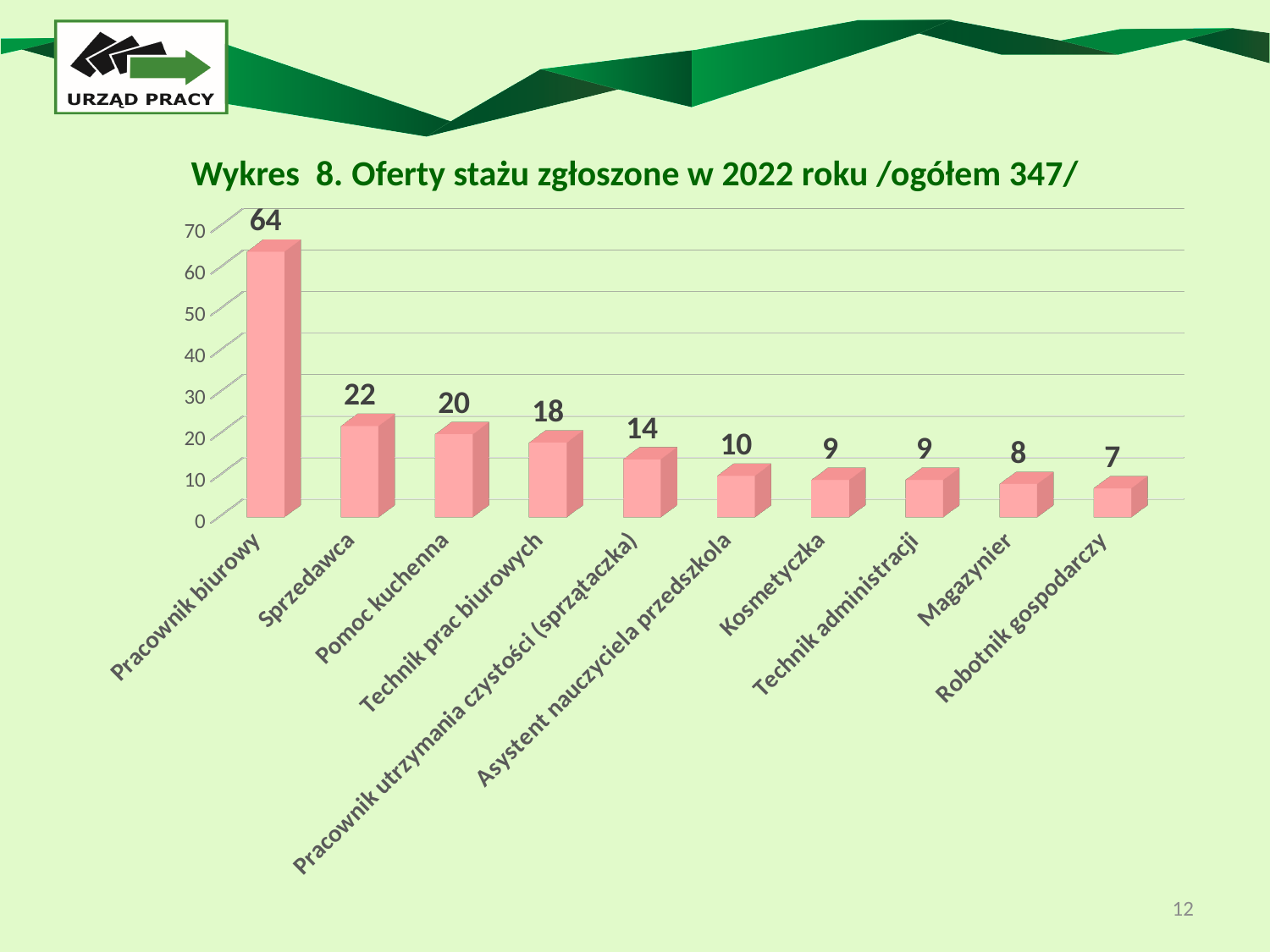
Which is larger, the value for Pracownik utrzymania czystości (sprzątaczka) or the value for Magazynier? Pracownik utrzymania czystości (sprzątaczka) What is the difference between the values for Pomoc kuchenna and Technik prac biurowych? 2 How many categories are shown on the chart? 10 What is the difference between the values for Pracownik biurowy and Sprzedawca? 42 What is the title of the chart? Wykres 8. Oferty stażu zgłoszone w 2022 roku /ogółem 347/ What is the value for Asystent nauczyciela przedszkola? 10 What is the value for Pracownik biurowy? 64 What is the value for Robotnik gospodarczy? 7 What kind of chart is shown on the slide? bar chart Which category has the lowest value? Robotnik gospodarczy What is the value for Sprzedawca? 22 Which category has the highest value? Pracownik biurowy